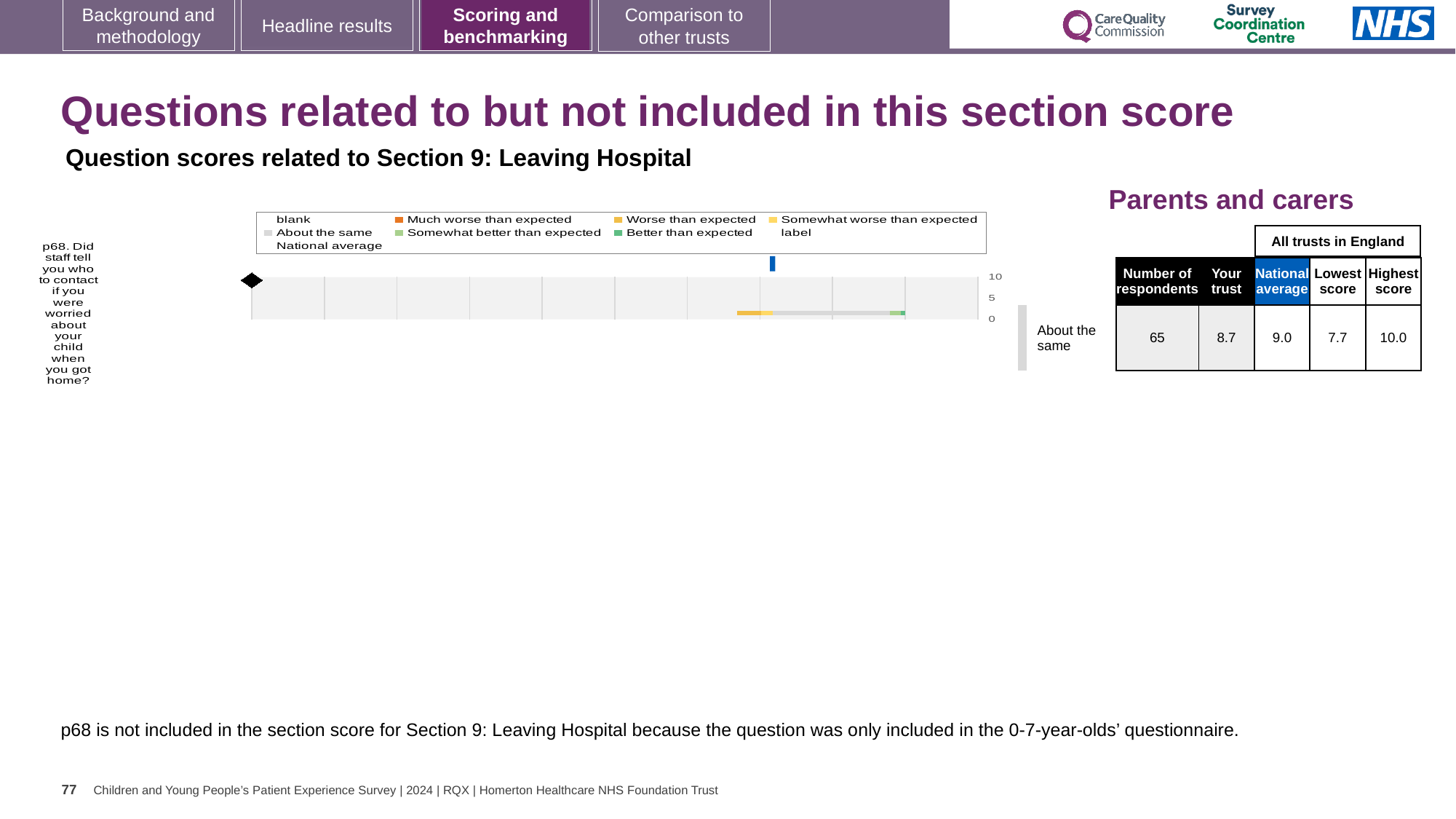
How many respondents answered p68? 65 What is the National average score for p68 in the table? 9.0 What is the Lowest score across all trusts in England for p68? 7.7 What is the Highest score across all trusts in England for p68? 10.0 What is the difference between the National average and the 'Your trust' score for p68? 0.3 Which is larger for p68, the 'Your trust' score or the National average? National average Which survey question is plotted in the chart? p68. Did staff tell you who to contact if you were worried about your child when you got home? What benchmark category is the trust's p68 score placed in? About the same What is the highest value shown on the chart's score axis? 10 What is the 'Your trust' score for p68 in the table? 8.7 What type of chart is shown on the slide? bar chart How many survey questions are plotted in the chart? 1